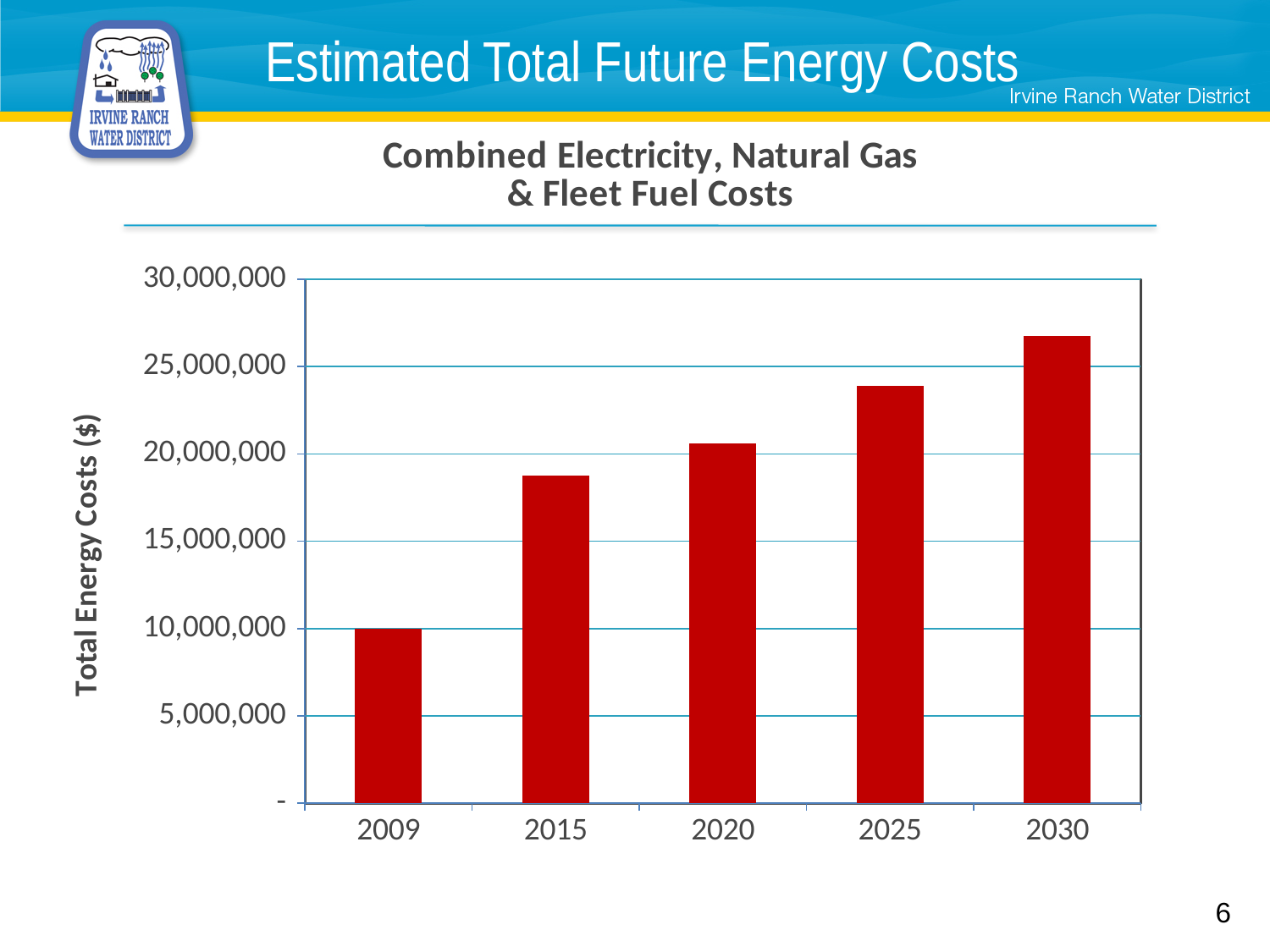
Which year has the highest total energy cost? 2030 Which is larger, the value for 2015 or the value for 2025? 2025 How many years are shown on the x axis of the chart? 5 Is the value for 2015 greater or less than 15,000,000? greater Is the value for 2025 greater or less than 25,000,000? less Is the value for 2030 greater or less than 25,000,000? greater Do the total energy costs rise or fall from 2009 to 2030? rise Which year has the lowest total energy cost? 2009 What kind of chart is shown on the slide? bar chart What is the title of the chart? Combined Electricity, Natural Gas & Fleet Fuel Costs What is the label on the vertical axis of the chart? Total Energy Costs ($)